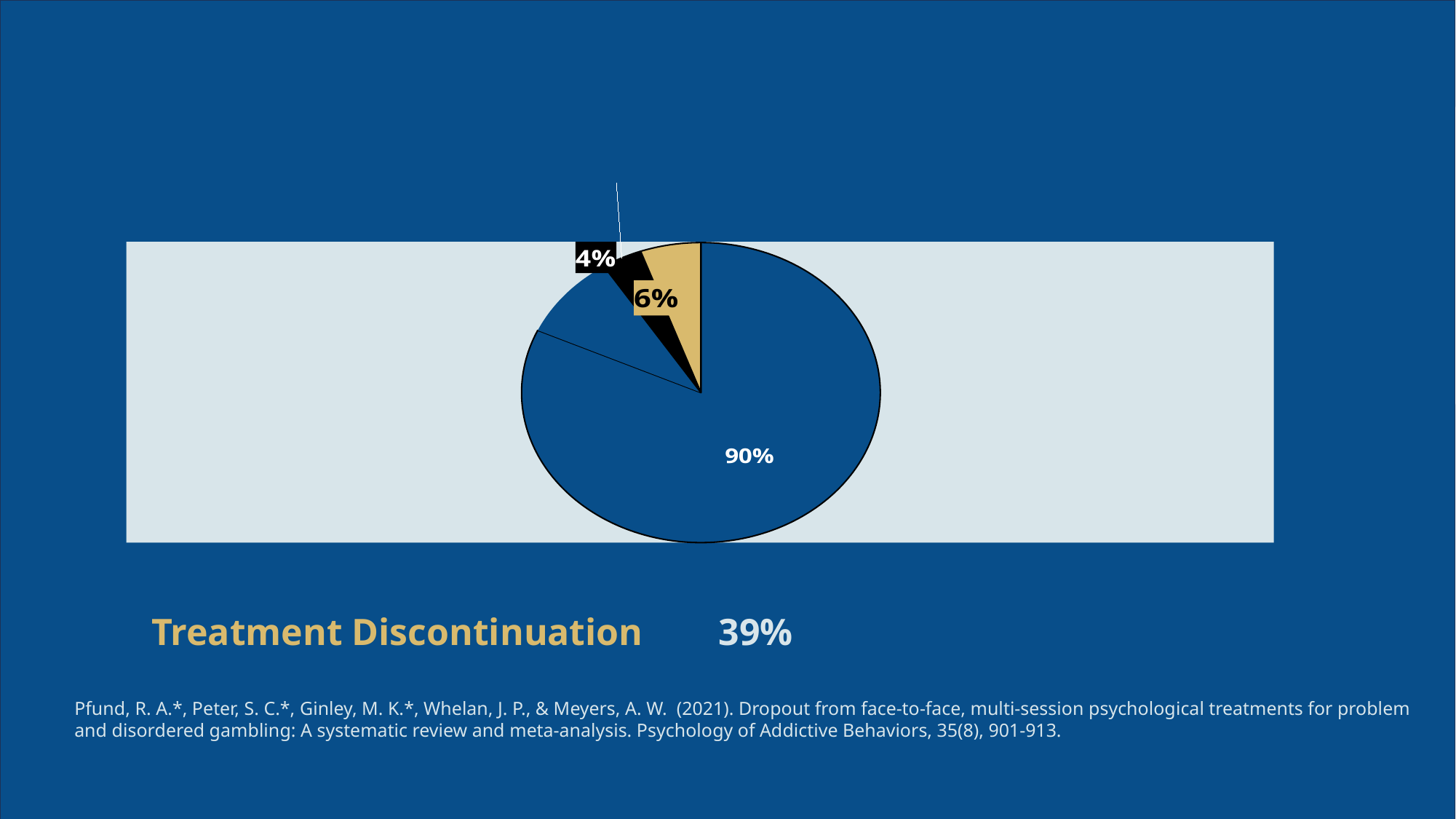
What is the combined share of the gold and black slices? 10% How many percentage labels are shown on the pie chart? 3 Is the largest slice of the pie chart greater or less than 50%? greater What is the value of the smallest slice of the pie chart? 4% What is the difference between the largest and smallest slices of the pie chart? 86 percentage points What heading text appears below the pie chart? Treatment Discontinuation What value is labelled on the blue slice of the pie chart? 90% What value is labelled on the black slice of the pie chart? 4% Which slice is larger, the gold slice or the black slice? the gold slice What kind of chart is shown on the slide? pie chart What is the value of the largest slice of the pie chart? 90% What value is labelled on the gold slice of the pie chart? 6%